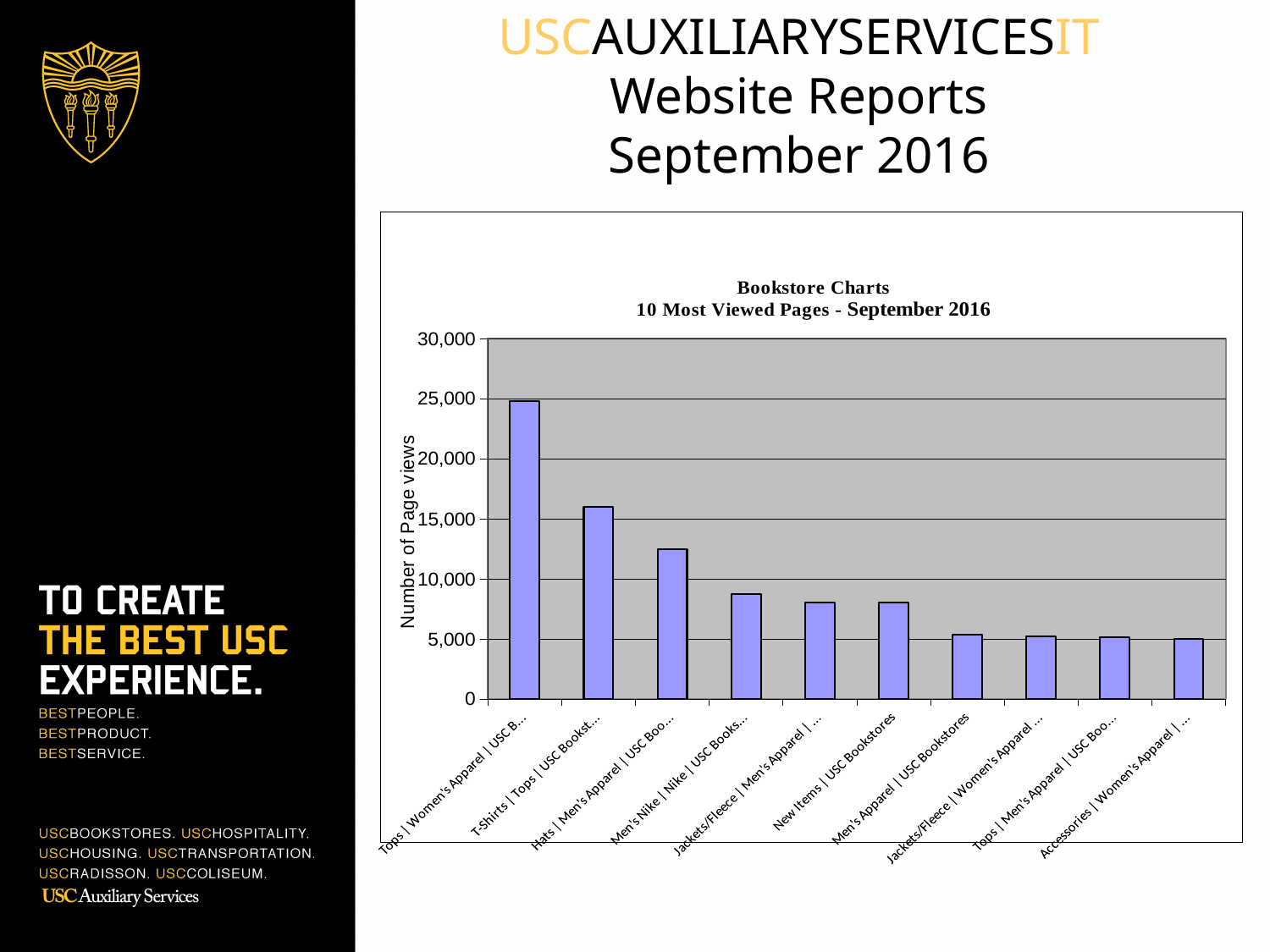
Is the value for Men's Nike | Nike greater or less than 10,000? less What kind of chart is shown on the slide? bar chart Is the value for Tops | Women's Apparel greater or less than 20,000? greater Do the values rise or fall moving from left to right along the x axis? fall What is the label on the vertical axis of the chart? Number of Page views How many categories (bars) are plotted in the chart? 10 What is the title of the chart? Bookstore Charts 10 Most Viewed Pages - September 2016 Which has more page views: Hats | Men's Apparel or Men's Nike | Nike? Hats | Men's Apparel Which page has the highest number of page views in the chart? Tops | Women's Apparel | USC B... Is the value for New Items | USC Bookstores greater or less than 10,000? less